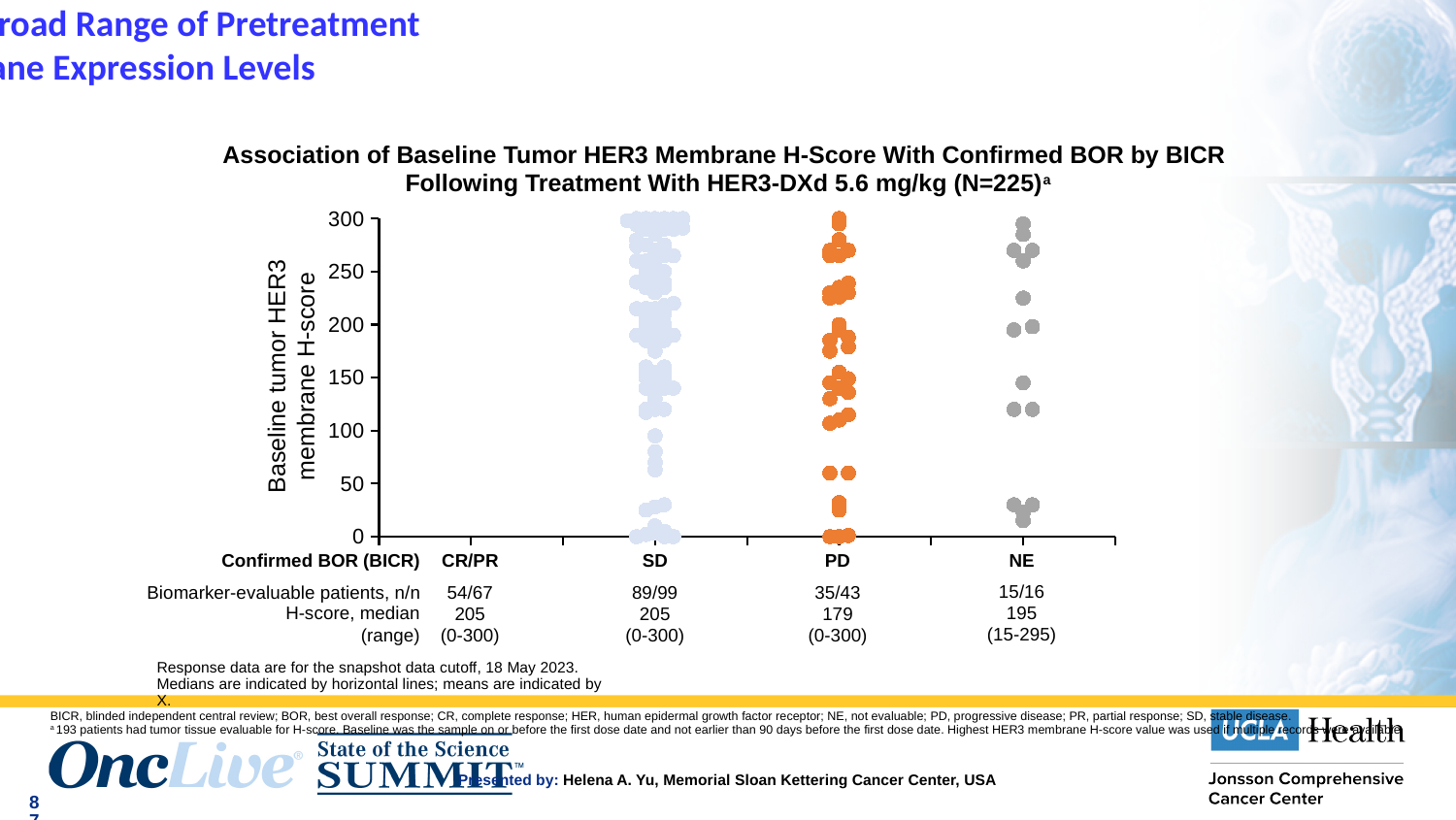
What is the difference between the median H-score of the CR/PR group and the PD group? 26 Which group has the larger median H-score, CR/PR or PD? CR/PR What is the total N stated in the chart title? 225 What is the label of the y axis? Baseline tumor HER3 membrane H-score How many biomarker-evaluable patients (n/n) are in the SD group? 89/99 What is the median H-score for the PD group? 179 How many confirmed BOR categories are shown along the x axis? 4 Which confirmed BOR group has the lowest median H-score? PD What is the highest value shown on the y axis? 300 What is the H-score range for the NE group? 15-295 What is the median H-score for the NE group? 195 What kind of chart is shown on the slide? dot plot